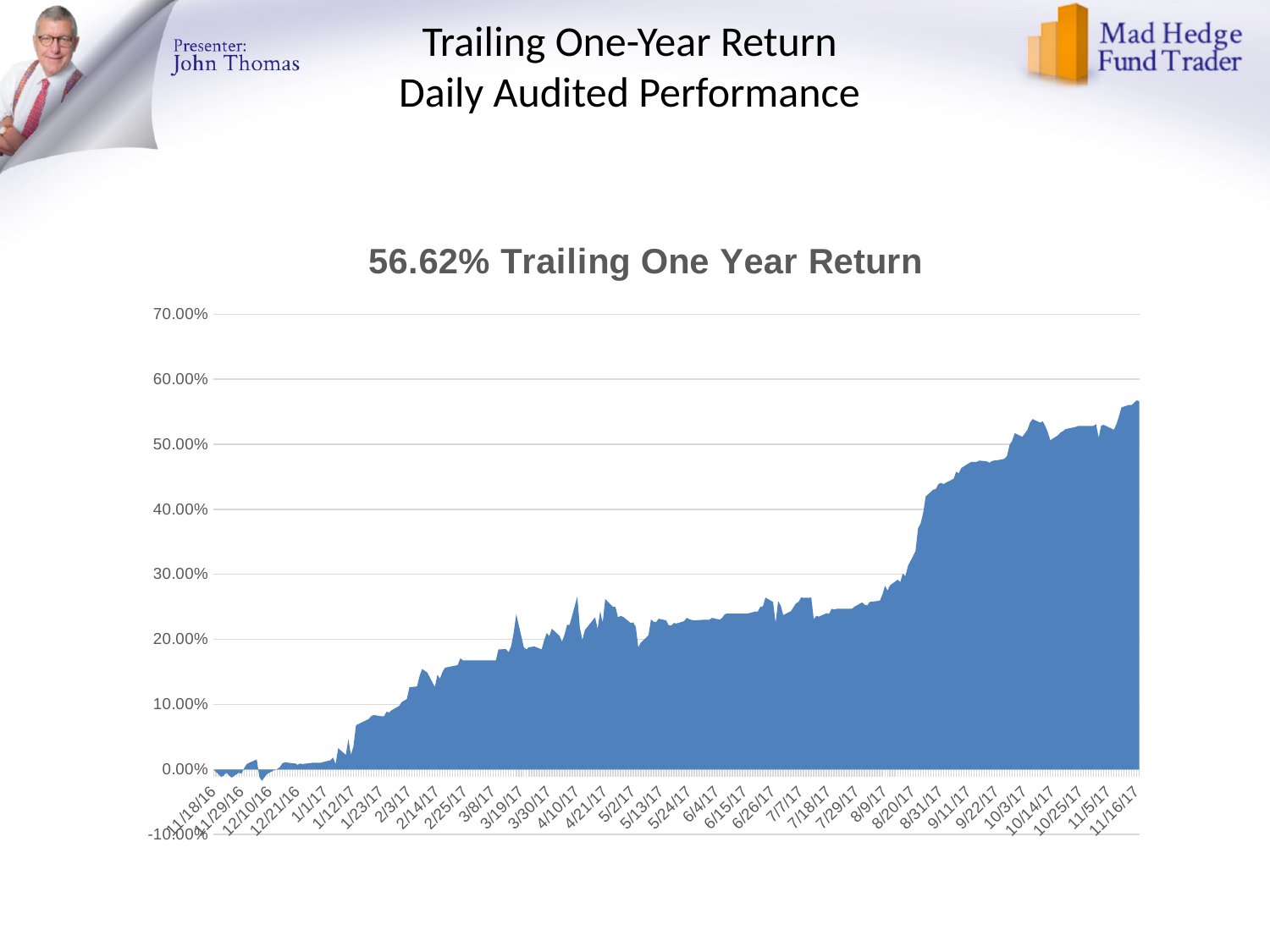
Which date shown on the x axis has the highest value, 11/16/17 or 5/2/17? 11/16/17 Is the value at 12/10/16 greater or less than 10.00%? less Is the value at 11/16/17 greater or less than 50.00%? greater Is the value at 8/31/17 greater or less than 40.00%? greater Do the values generally rise or fall from 11/18/16 to 11/16/17? rise What kind of chart is shown on the slide? area chart What is the highest tick value shown on the y axis? 70.00% What trailing one-year return value is stated in the chart title? 56.62% What is the title of the chart? 56.62% Trailing One Year Return